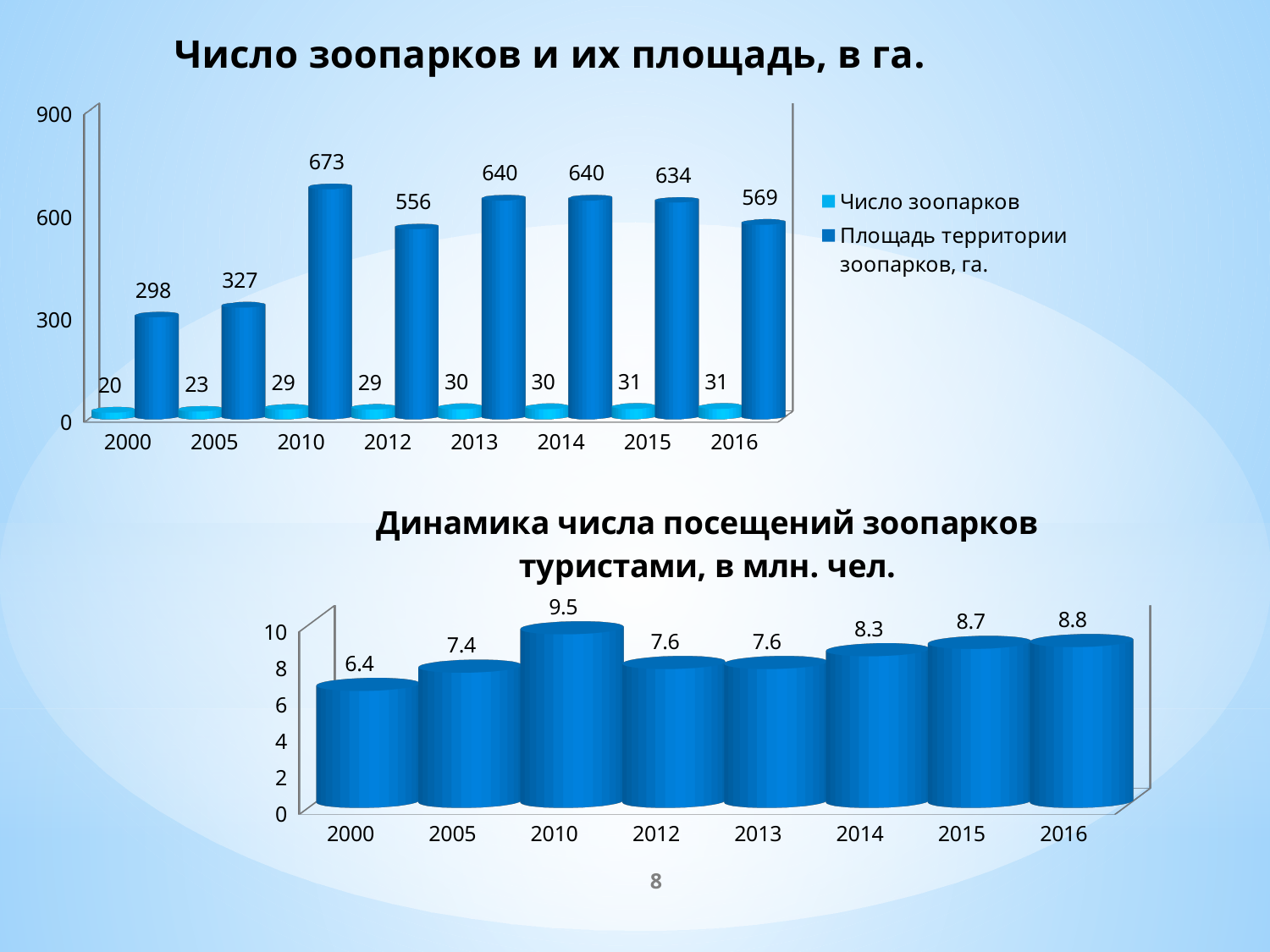
What kind of chart is the bottom chart on the slide? bar chart In the chart 'Динамика числа посещений зоопарков туристами, в млн. чел.', what is the difference between the values for 2016 and 2000? 2.4 In the chart 'Динамика числа посещений зоопарков туристами, в млн. чел.', which is larger, the value for 2014 or the value for 2015? 2015 In the chart 'Динамика числа посещений зоопарков туристами, в млн. чел.', what is the value for 2010? 9.5 In the chart 'Число зоопарков и их площадь, в га.', what is the difference between the 'Площадь территории зоопарков, га.' values for 2010 and 2016? 104 In the chart 'Число зоопарков и их площадь, в га.', which year has the highest value for 'Площадь территории зоопарков, га.'? 2010 In the chart 'Число зоопарков и их площадь, в га.', how many years are shown on the x axis? 8 In the chart 'Число зоопарков и их площадь, в га.', what is the value of 'Площадь территории зоопарков, га.' for 2010? 673 In the chart 'Число зоопарков и их площадь, в га.', which year has the lowest value for 'Площадь территории зоопарков, га.'? 2000 In the chart 'Число зоопарков и их площадь, в га.', how many series does the legend list? 2 In the chart 'Динамика числа посещений зоопарков туристами, в млн. чел.', which year has the lowest value? 2000 In the chart 'Число зоопарков и их площадь, в га.', what is the value of 'Число зоопарков' for 2000? 20